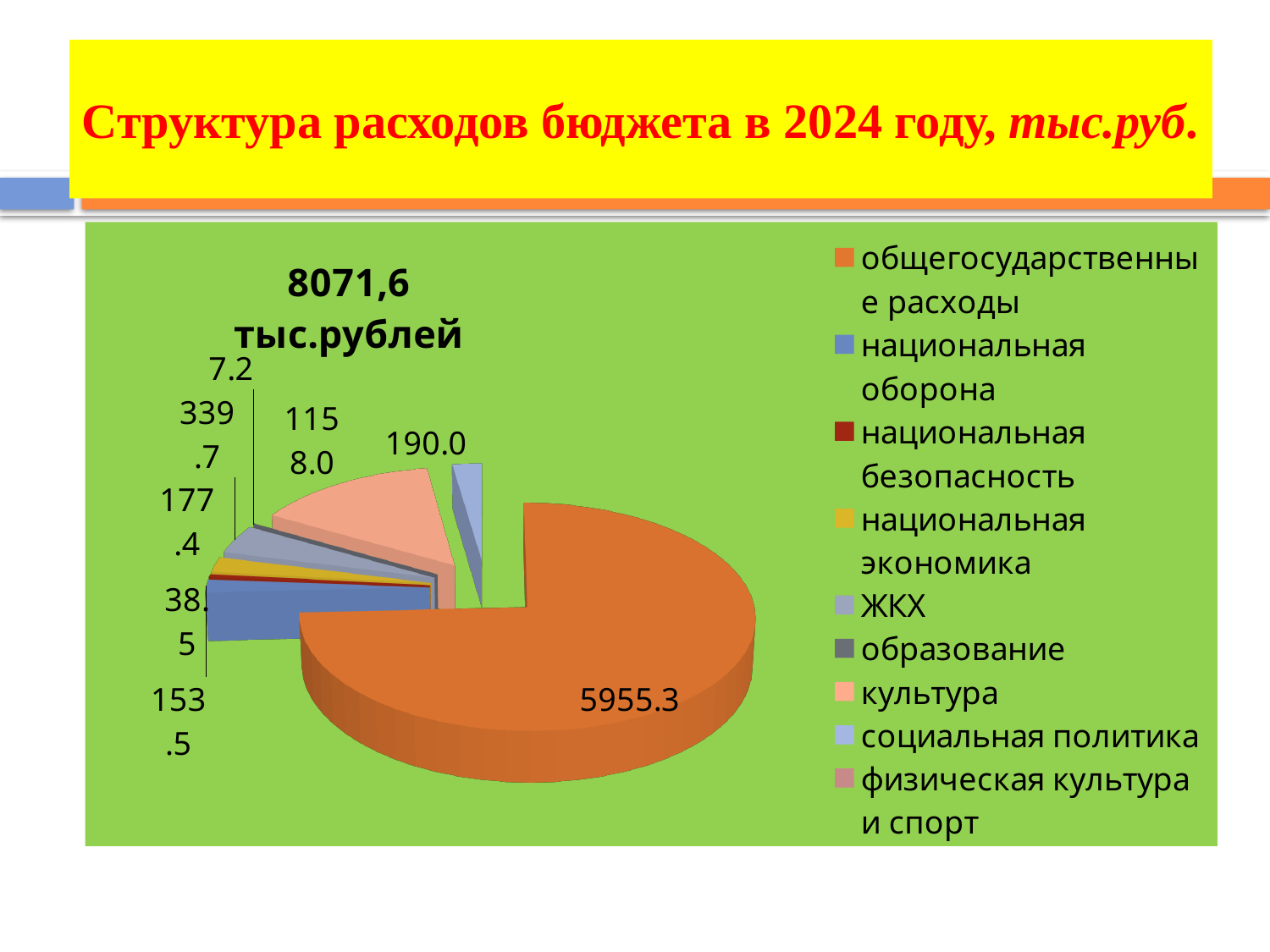
How many categories does the legend of the pie chart list? 9 Which category has the largest slice in the pie chart? общегосударственные расходы What is the title of the slide? Структура расходов бюджета в 2024 году, тыс.руб. What is the smallest value labelled on the pie chart? 7.2 What is the value labelled for культура? 1158.0 What is the value labelled for общегосударственные расходы? 5955.3 Which is larger, the slice for культура or the slice for национальная оборона? культура What is the difference between the values for общегосударственные расходы and культура? 4797.3 What total is shown as the title of the pie chart? 8071,6 тыс.рублей What type of chart is shown on the slide? pie chart Which is larger, the value for общегосударственные расходы or the value for культура? общегосударственные расходы What share of the total 8071,6 does the общегосударственные расходы slice (5955.3) represent, to one decimal place? 73.8%